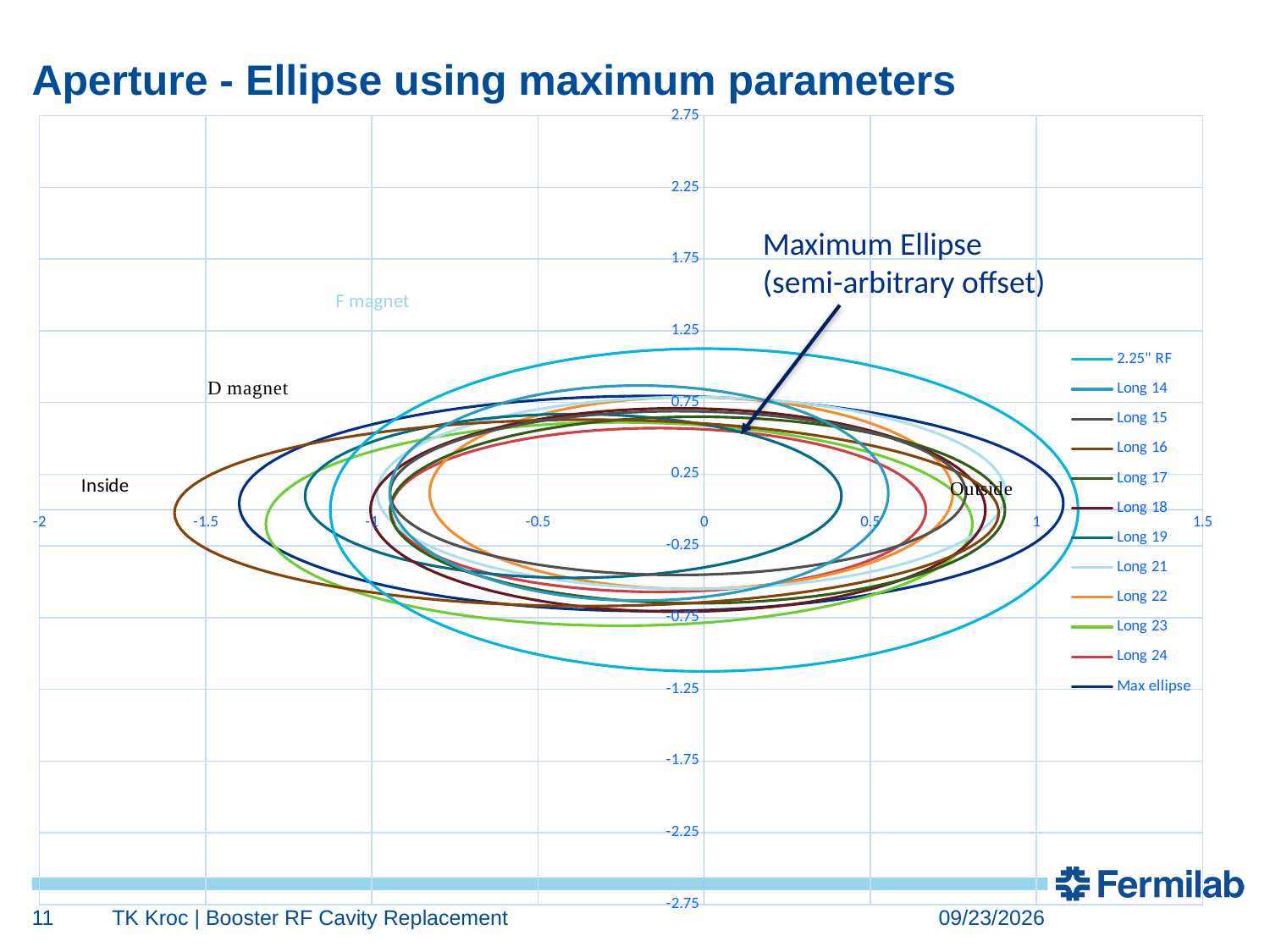
What is the title of the slide's chart? Aperture - Ellipse using maximum parameters Which series extends furthest to the left (toward the 'Inside' side) on the x axis? Long 16 How many series does the chart legend list? 12 Is the rightmost extent of the Max ellipse greater or less than 1 on the x axis? greater Which legend entry is listed last in the chart legend? Max ellipse What kind of chart is shown on the slide? Line (scatter) chart of ellipses Which series reaches the highest point on the y axis? 2.25" RF Which ellipse is larger overall, the 2.25" RF ellipse or the Long 19 ellipse? 2.25" RF Is the leftmost extent of the Long 16 ellipse greater or less than -1.5 on the x axis? less What is the maximum value shown on the y axis? 2.75 Is the top of the 2.25" RF ellipse greater or less than 1.25 on the y axis? less